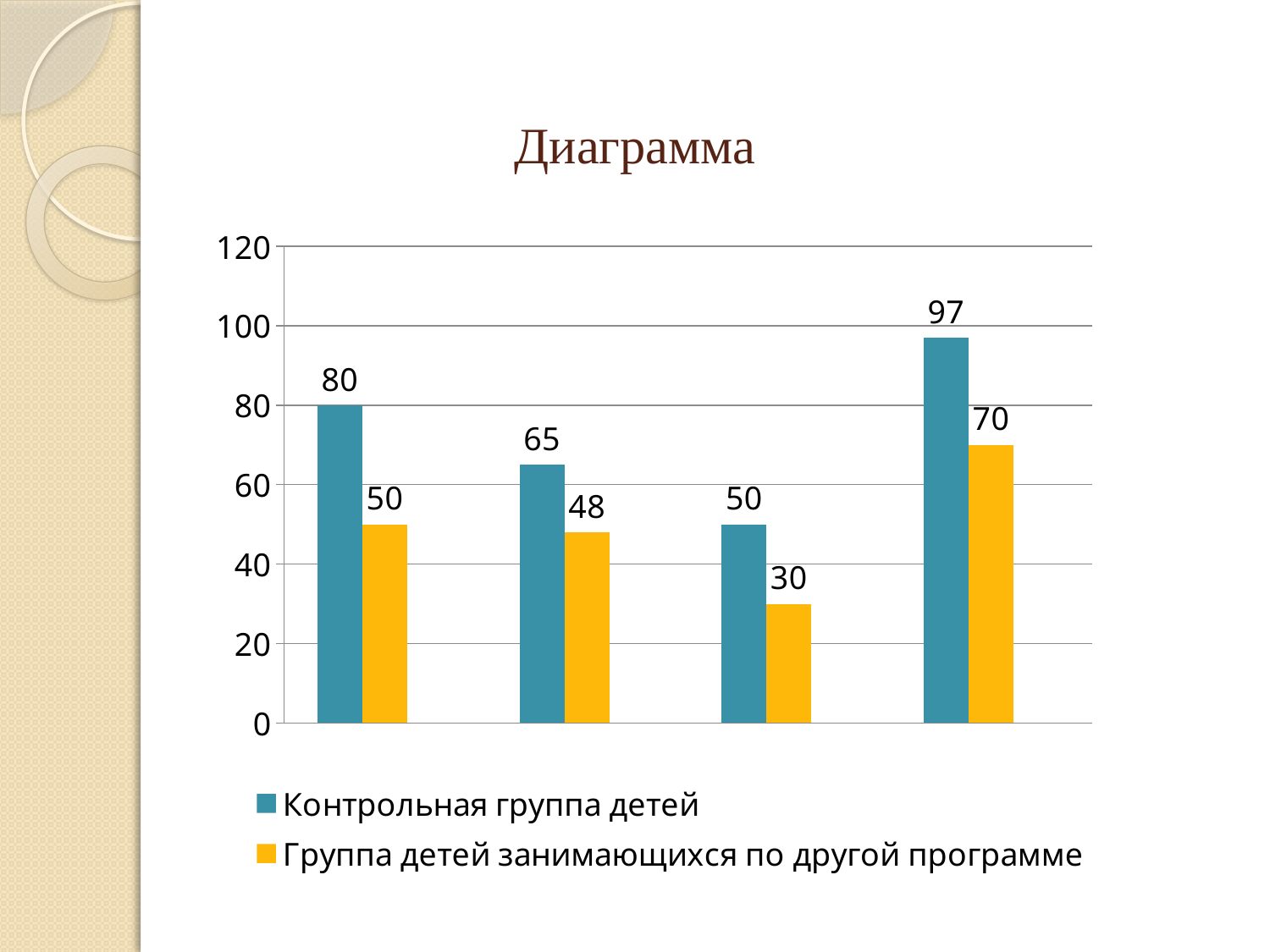
What is the difference between the Контрольная группа детей values in the first and second groups of bars? 15 What is the title of the slide? Диаграмма In which group of bars (by position from left) does the Контрольная группа детей series reach its highest value? fourth What type of chart is shown on the slide? bar chart What is the difference between the two series in the fourth group of bars? 27 What is the value of the Группа детей занимающихся по другой программе series for the third group of bars? 30 How many groups of bars are shown on the chart? 4 How many series does the legend list? 2 In which group of bars (by position from left) does the Группа детей занимающихся по другой программе series have its lowest value? third What is the value of the Контрольная группа детей series for the fourth group of bars? 97 In the second group of bars, which series has the larger value? Контрольная группа детей What is the value of the Контрольная группа детей series for the first group of bars? 80